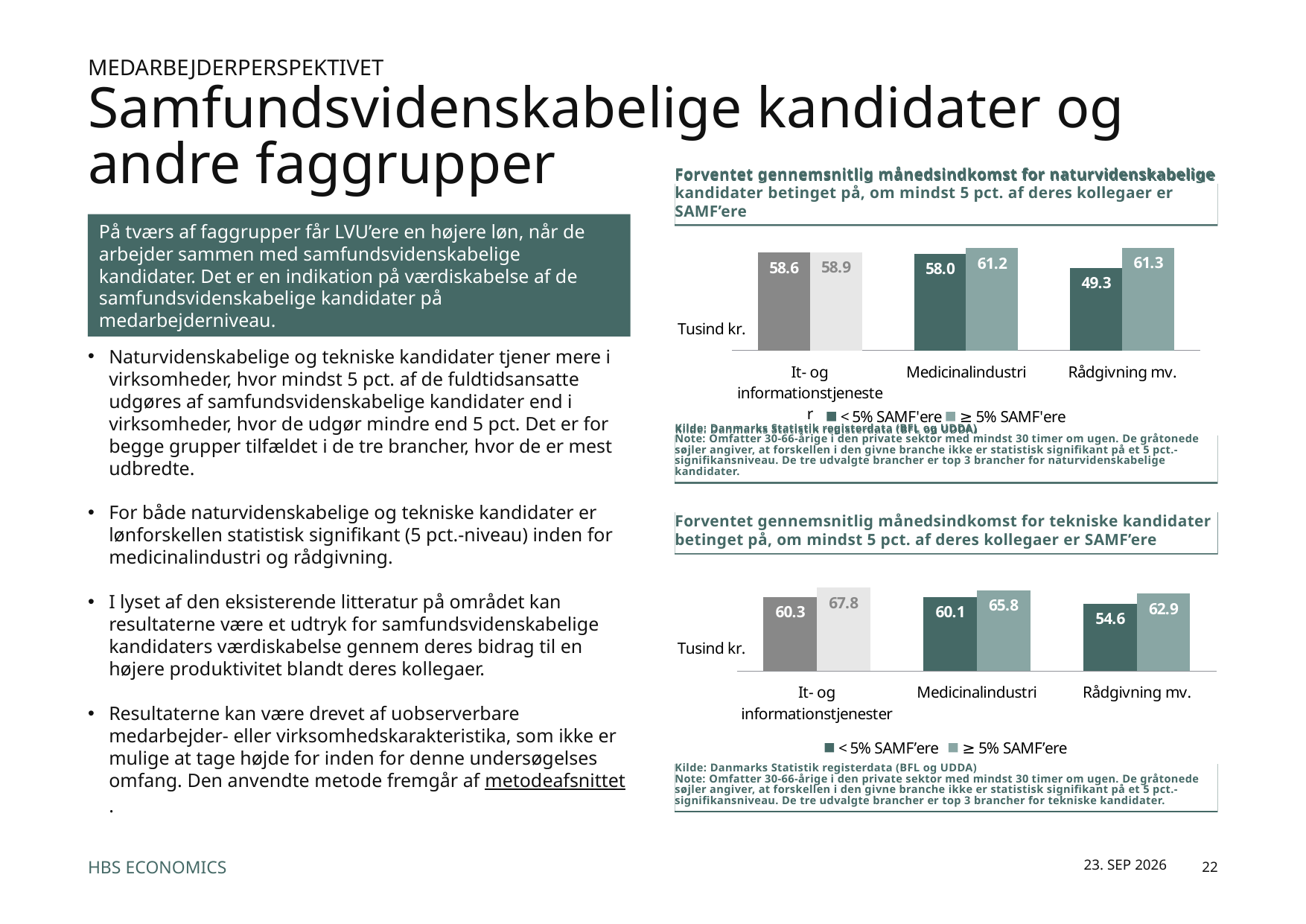
In the top chart (naturvidenskabelige kandidater), what is the difference between the '≥ 5% SAMF'ere' and '< 5% SAMF'ere' values for Rådgivning mv.? 12.0 How many categories are shown on the x axis of the top chart (naturvidenskabelige kandidater)? 3 In the bottom chart (tekniske kandidater), what is the difference between the '≥ 5% SAMF'ere' and '< 5% SAMF'ere' values for Medicinalindustri? 5.7 In the top chart (naturvidenskabelige kandidater), what is the value for Rådgivning mv. in the '< 5% SAMF'ere' series? 49.3 In the top chart (naturvidenskabelige kandidater), what is the value for Medicinalindustri in the '≥ 5% SAMF'ere' series? 61.2 In the top chart (naturvidenskabelige kandidater), which category has the lowest value in the '< 5% SAMF'ere' series? Rådgivning mv. In the bottom chart (tekniske kandidater), which is larger for It- og informationstjenester: the '< 5% SAMF'ere' value or the '≥ 5% SAMF'ere' value? ≥ 5% SAMF'ere How many series does the legend of the bottom chart (tekniske kandidater) list? 2 In the bottom chart (tekniske kandidater), what is the value for Rådgivning mv. in the '< 5% SAMF'ere' series? 54.6 In the bottom chart (tekniske kandidater), what is the value for It- og informationstjenester in the '≥ 5% SAMF'ere' series? 67.8 In the bottom chart (tekniske kandidater), which category has the highest value in the '≥ 5% SAMF'ere' series? It- og informationstjenester What kind of chart is the top chart (naturvidenskabelige kandidater)? Bar chart